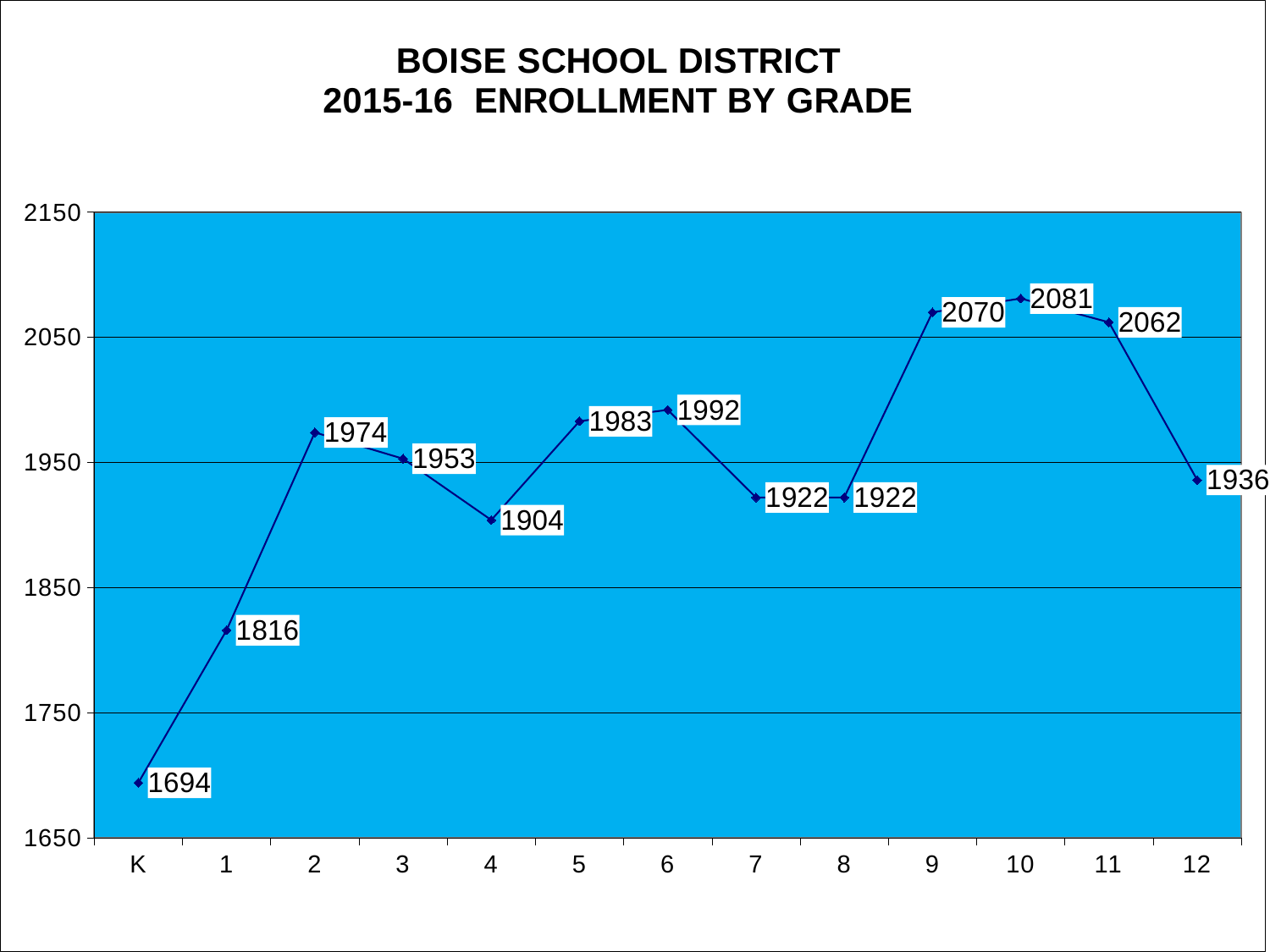
What is the difference in enrollment between grade 10 and grade K? 387 What is the enrollment for grade 10? 2081 Which has a larger enrollment, grade 6 or grade 12? grade 6 Which grade has the lowest enrollment? K How many grades are plotted on the chart? 13 What kind of chart is shown on the slide? line chart What is the title of the chart? BOISE SCHOOL DISTRICT 2015-16 ENROLLMENT BY GRADE What is the enrollment for grade 4? 1904 Is the enrollment for grade 9 greater or less than 2050? greater What is the enrollment for grade K? 1694 Which grade has the highest enrollment? 10 What is the difference in enrollment between grade 2 and grade 1? 158